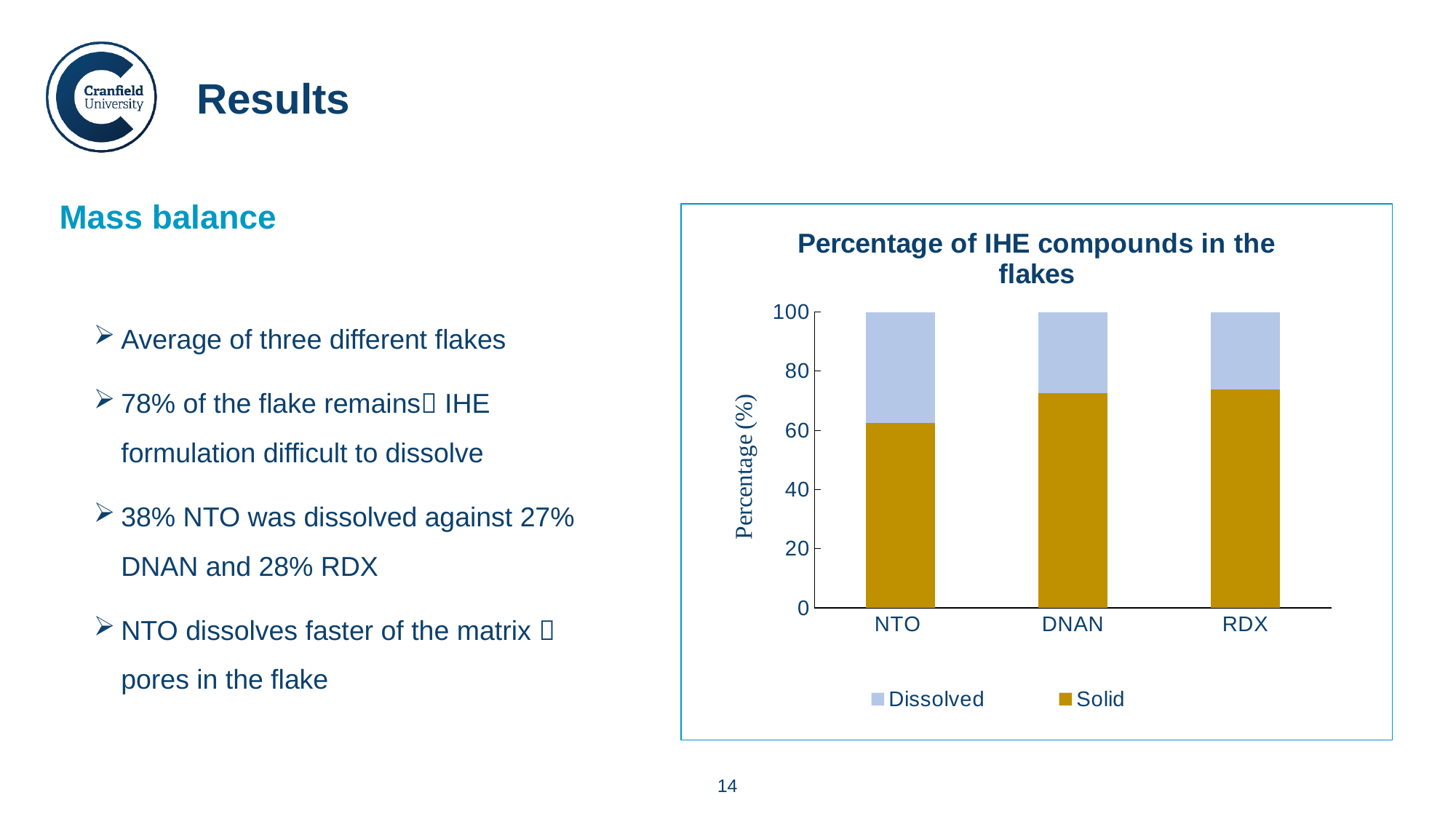
How many series does the chart legend list? 2 What is the total height of the stacked bar for NTO in the chart? 100 Is the Solid percentage for DNAN greater or less than 60? greater What kind of chart is shown on the slide? Stacked bar chart Is the Solid percentage for NTO greater or less than 80? less Which compound has the highest Dissolved percentage in the chart? NTO How many compounds (categories) are shown on the x axis of the chart? 3 What is the title of the chart? Percentage of IHE compounds in the flakes Which series is shown in gold/dark yellow in the chart? Solid Which compound has the lowest Solid percentage in the chart? NTO Is the Solid percentage for RDX greater or less than 80? less Which is larger in the chart: the Solid percentage for NTO or for DNAN? DNAN